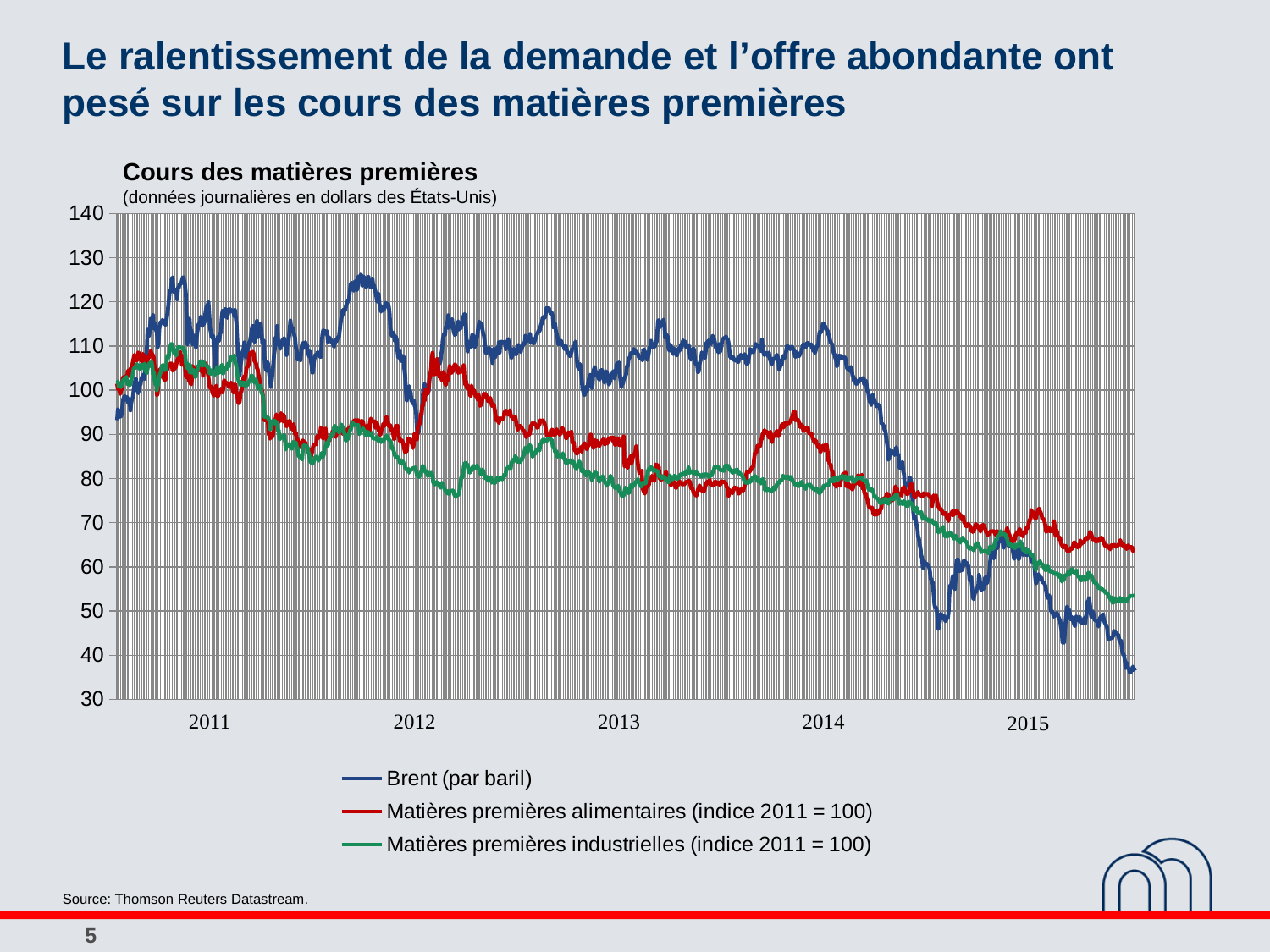
Is the value of Matières premières industrielles at the end of 2015 greater or less than 50? greater How many years are labelled on the x axis? 5 Which series is drawn in blue? Brent (par baril) Is the value of Brent at the end of 2015 greater or less than 40? less Is the value of Matières premières alimentaires at the end of 2015 greater or less than 60? greater How many series does the legend list? 3 Does the Brent series rise or fall from mid-2014 to the end of 2015? fall At the end of 2015, which is higher: Brent or Matières premières alimentaires? Matières premières alimentaires What kind of chart is shown on the slide? line chart What is the title of the chart? Cours des matières premières Which series has the lowest value at the end of 2015? Brent (par baril)